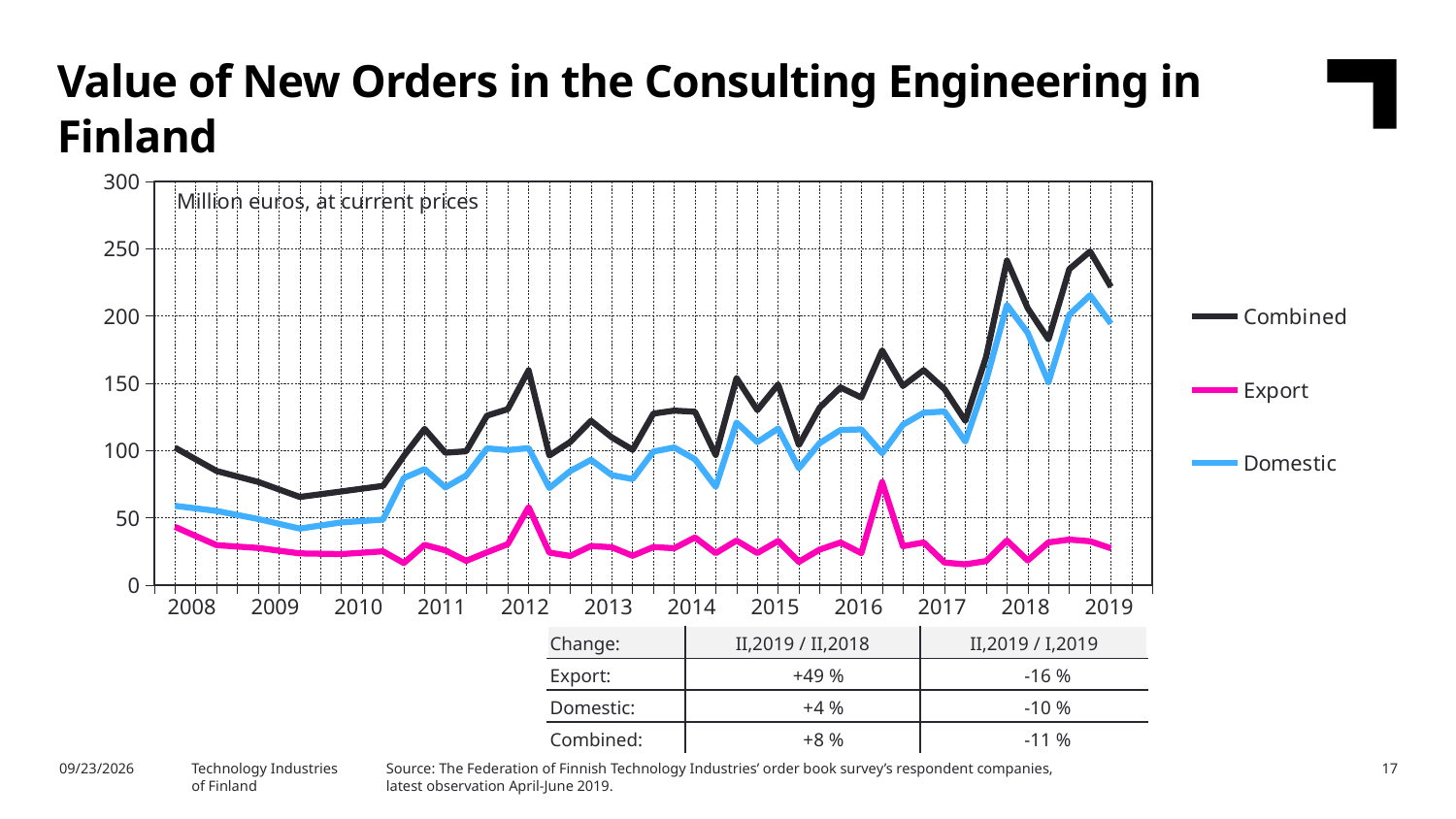
Is the peak of the Export line around 2016 greater or less than 50? greater According to the change table below the chart, what is the Export change for II,2019 / II,2018? +49 % What kind of chart is shown on the slide? line chart What unit is stated in the label inside the plot area? Million euros, at current prices Is the highest point of the Combined line (around 2018) greater or less than 200? greater What are the three series named in the legend? Combined, Export, Domestic Which series has the highest values across the whole chart? Combined Is the value of the Domestic line at the start of 2008 greater or less than 100? less How many series does the legend list? 3 How many years are labelled on the x axis? 12 Does the Combined line overall rise or fall from 2008 to 2019? rise Which series has the lowest values across the whole chart? Export